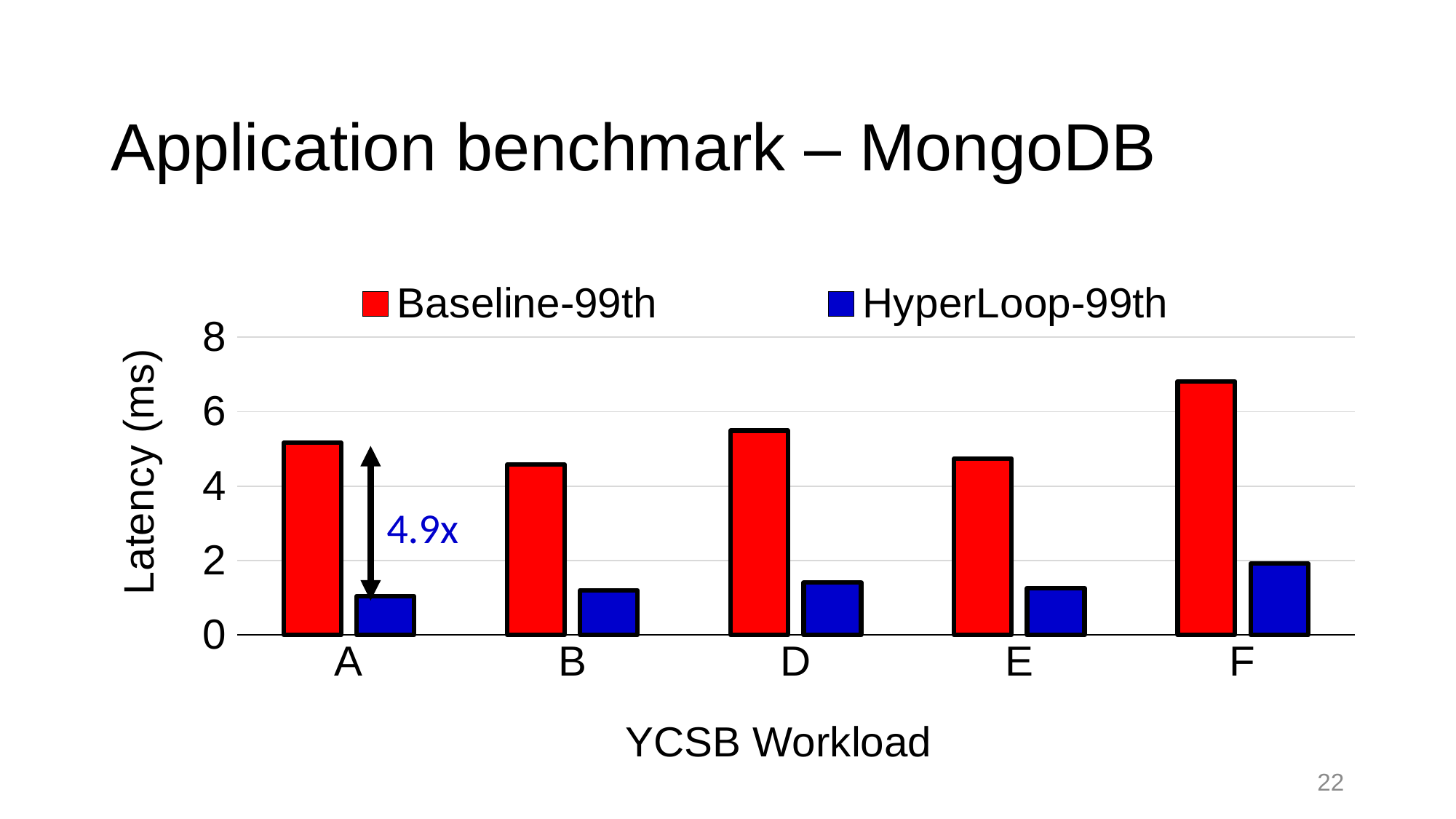
Which workload has the highest Baseline-99th latency? F Is the Baseline-99th latency for workload F greater or less than 6? greater What speedup factor is annotated between the two bars for workload A? 4.9x How many series does the legend list? 2 Which workload has the highest HyperLoop-99th latency? F Is the HyperLoop-99th latency for workload D greater or less than 2? less Which is larger, the Baseline-99th latency for workload D or for workload B? workload D Is the Baseline-99th latency for workload A greater or less than 4? greater How many YCSB workloads are shown on the x axis? 5 What is the label of the y axis? Latency (ms) What kind of chart is shown on the slide? bar chart